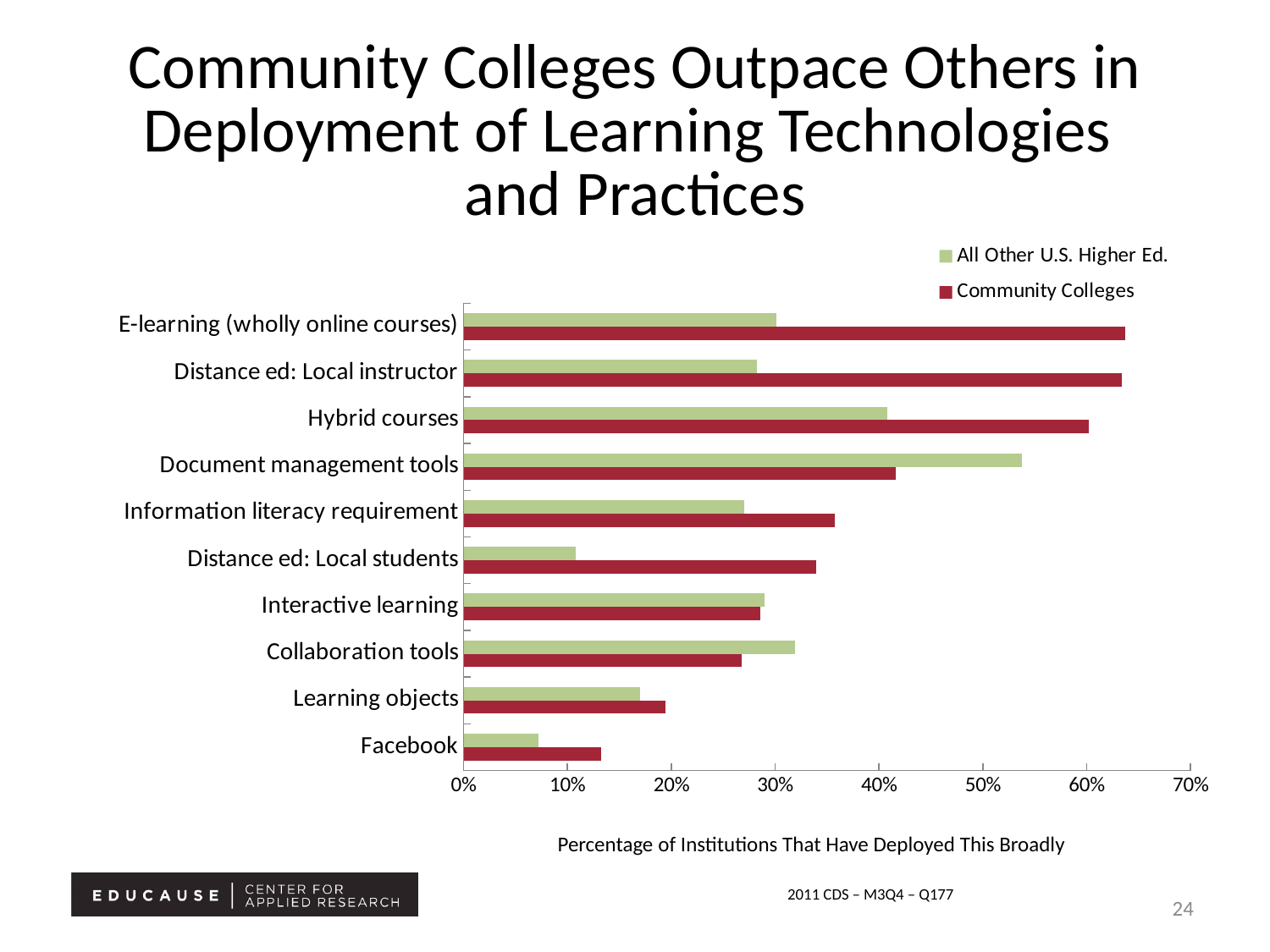
Is the Community Colleges value for Hybrid courses greater or less than 50%? greater For Distance ed: Local students, which series has the larger value: Community Colleges or All Other U.S. Higher Ed.? Community Colleges Which category has the highest value for All Other U.S. Higher Ed.? Document management tools What kind of chart is shown on the slide? Bar chart Is the All Other U.S. Higher Ed. value for Distance ed: Local students greater or less than 20%? less Is the Community Colleges value for E-learning (wholly online courses) greater or less than 60%? greater How many series does the legend list? 2 How many categories (technologies/practices) are plotted on the chart? 10 Which category has the lowest value for Community Colleges? Facebook Which category has the lowest value for All Other U.S. Higher Ed.? Facebook For Document management tools, which series has the larger value: Community Colleges or All Other U.S. Higher Ed.? All Other U.S. Higher Ed. What is the label on the horizontal axis of the chart? Percentage of Institutions That Have Deployed This Broadly